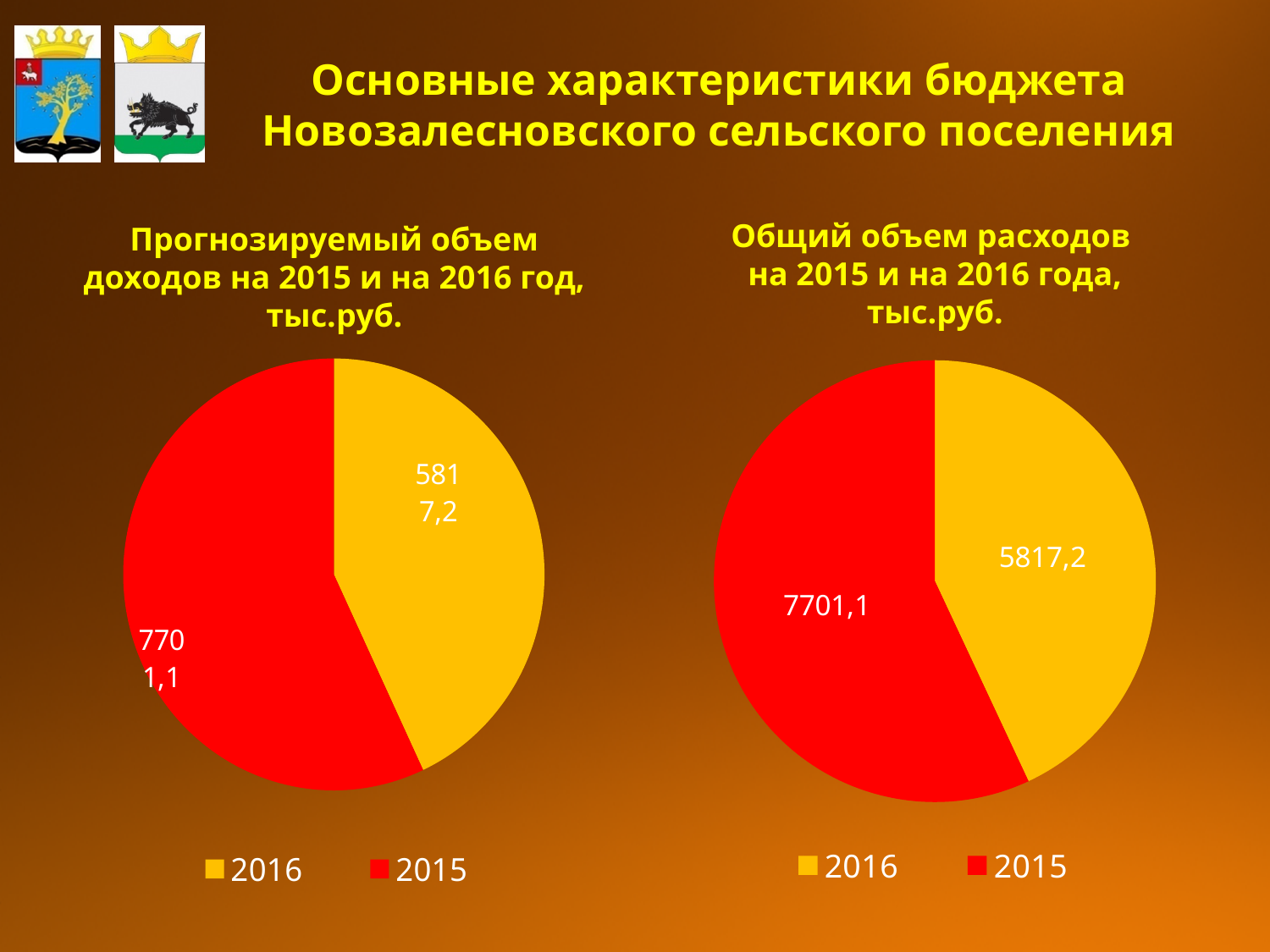
In the right chart (Общий объем расходов), which year has the larger slice? 2015 In the right chart (Общий объем расходов), what is the value for 2015? 7701,1 In the left chart (Прогнозируемый объем доходов), what is the value for 2015? 7701,1 How many slices does the left chart (Прогнозируемый объем доходов) have? 2 In the left chart (Прогнозируемый объем доходов), which year has the smaller slice? 2016 In the right chart (Общий объем расходов), is the value for 2015 larger or smaller than the value for 2016? larger In the right chart (Общий объем расходов), what is the difference between the 2015 and 2016 values? 1883,9 In the right chart (Общий объем расходов), what colour is the slice for 2016? yellow In the left chart (Прогнозируемый объем доходов), what is the value for 2016? 5817,2 How many entries does the legend of the right chart (Общий объем расходов) list? 2 What type of chart is used on the left of the slide (Прогнозируемый объем доходов)? pie chart In the right chart (Общий объем расходов), what is the value for 2016? 5817,2